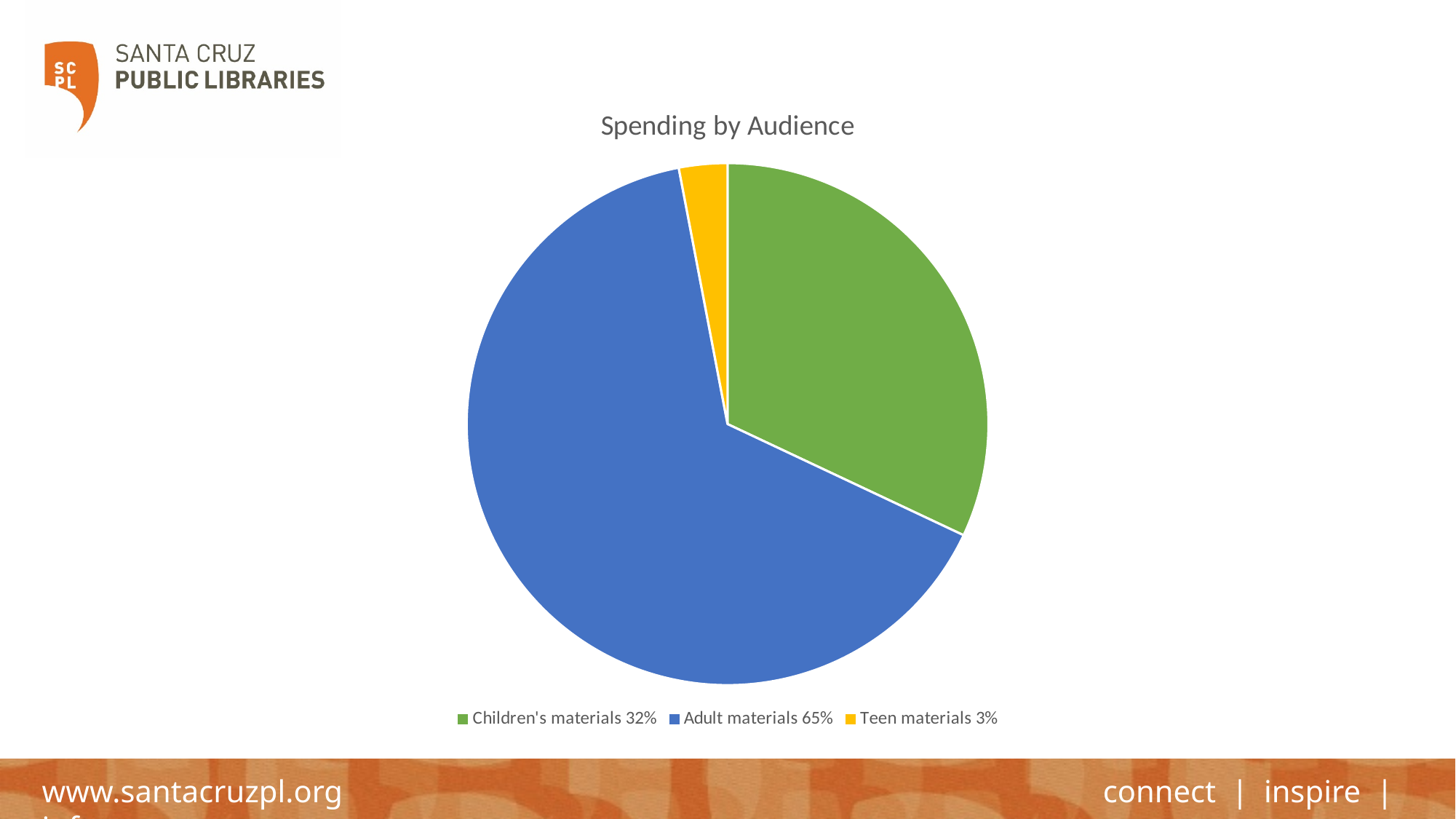
Which audience category has the largest share of spending? Adult materials Which has a larger share, Children's materials or Teen materials? Children's materials What is the difference in percentage points between Adult materials and Children's materials? 33 What share of spending goes to Adult materials? 65% What share of spending goes to Teen materials? 3% What is the difference in percentage points between Children's materials and Teen materials? 29 What is the title of the chart? Spending by Audience What share of spending goes to Children's materials? 32% What kind of chart is shown on the slide? pie chart What colour is the Adult materials slice? blue Which audience category has the smallest share of spending? Teen materials How many slices does the pie chart have? 3